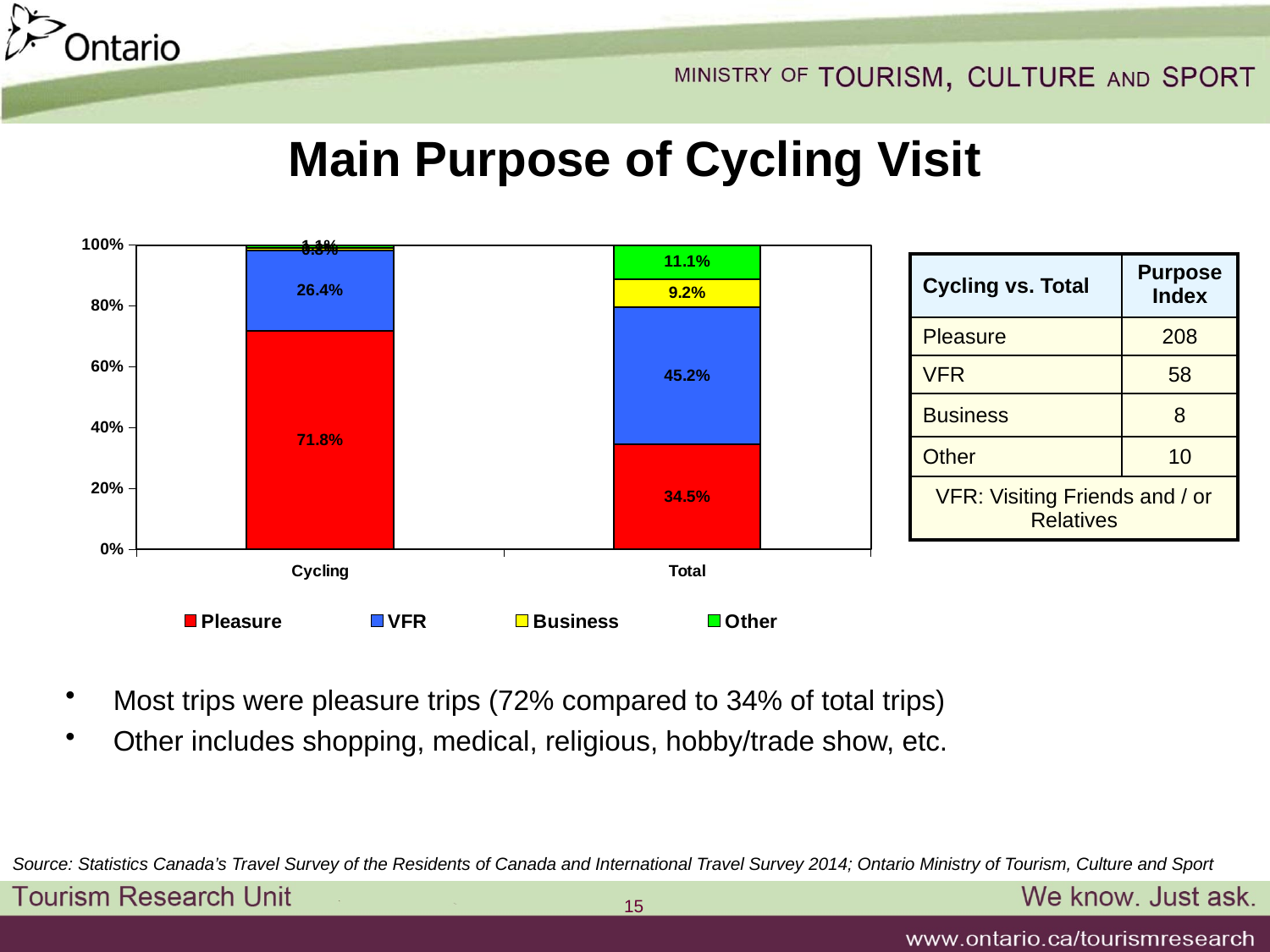
What kind of chart is shown on the slide? Stacked bar chart How many categories are shown on the x axis? 2 What is the VFR share for the Cycling category? 26.4% Which category has the larger VFR share, Cycling or Total? Total What is the Business share for the Total category? 9.2% What is the Other share for the Total category? 11.1% What is the VFR share for the Total category? 45.2% How many series does the legend list? 4 Which purpose has the largest share in the Total bar? VFR How many percentage points higher is the Pleasure share for Cycling than for Total? 37.3 percentage points What percentage of cycling visits were for Pleasure? 71.8% What is the Pleasure share for the Total category? 34.5%